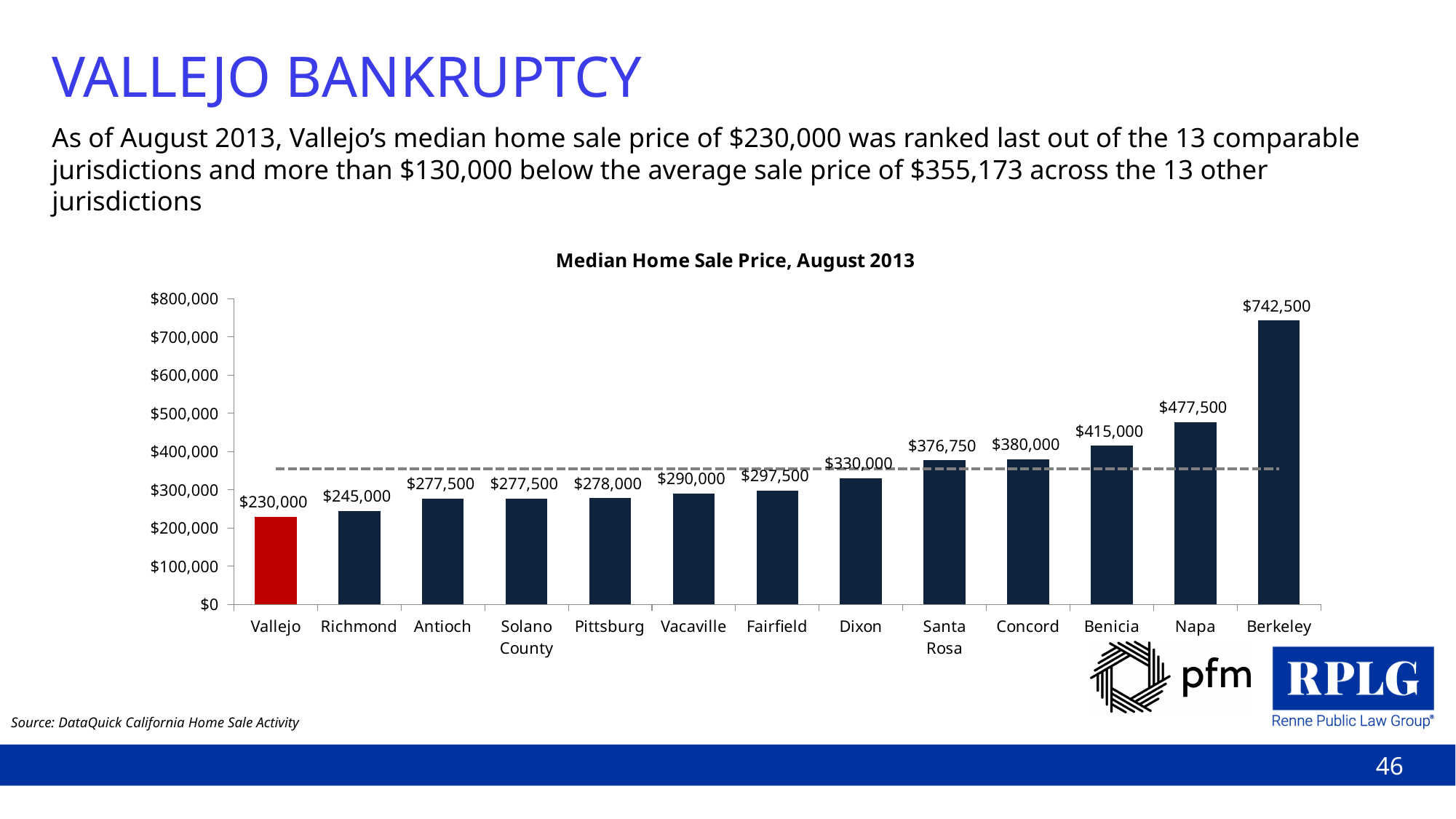
How many jurisdictions are shown on the chart? 13 Which has a higher median home sale price, Benicia or Dixon? Benicia What is the title of the chart? Median Home Sale Price, August 2013 What is the difference between Concord's and Richmond's median home sale prices? $135,000 Is the value for Fairfield greater or less than $300,000? less What is the median home sale price for Napa? $477,500 What kind of chart is shown on the slide? Bar chart What is the difference between Berkeley's and Vallejo's median home sale prices? $512,500 What is the median home sale price for Vallejo? $230,000 What is the median home sale price for Santa Rosa? $376,750 Which jurisdiction has the lowest median home sale price? Vallejo Which jurisdiction has the highest median home sale price? Berkeley